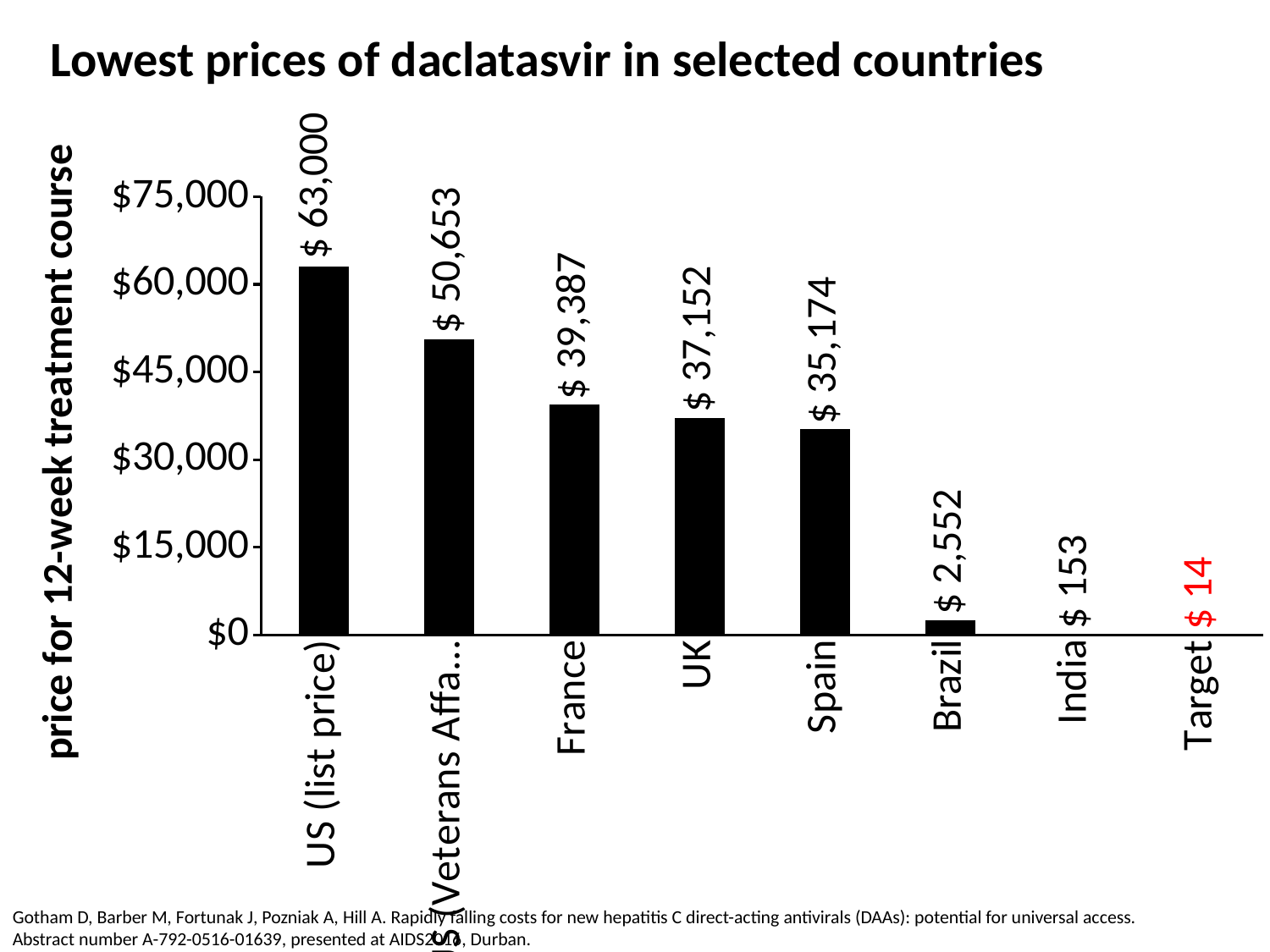
What is the value shown for India? $ 153 What is the value shown for Target? $ 14 What is the value shown for the UK? $ 37,152 What is the lowest price of daclatasvir shown for France? $ 39,387 Is the value for Spain greater or less than $30,000? greater How many categories are shown on the x axis? 8 Which category has the lowest value? Target What is the value shown for Brazil? $ 2,552 What is the difference between the values for France and the UK? $ 2,235 Which category has the highest price? US (list price) Which is larger, the value for the UK or the value for Spain? UK Do the values rise or fall from left to right along the x axis? fall